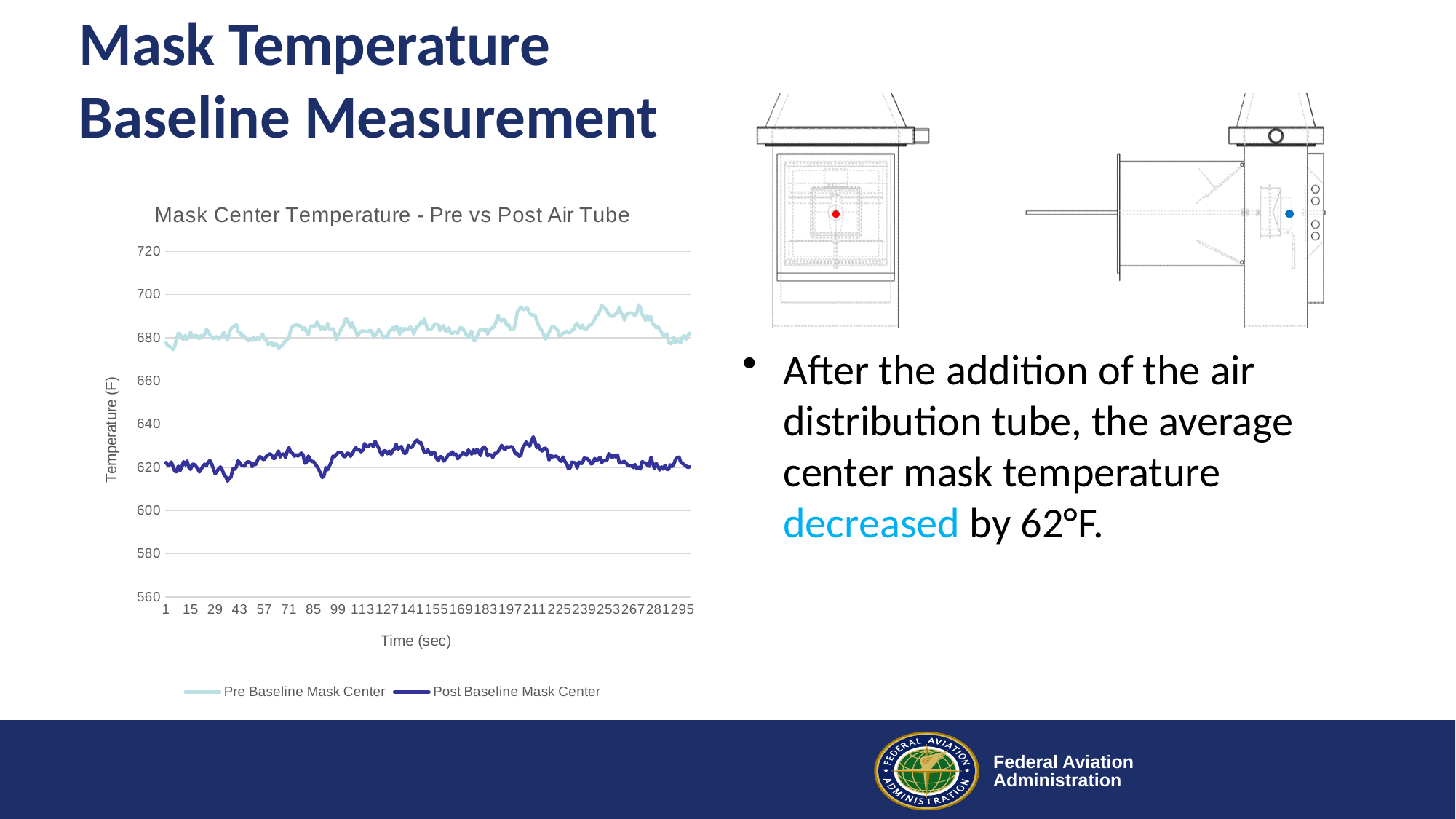
Is the Post Baseline Mask Center temperature greater or less than 600 across the chart? greater What is the title of the chart? Mask Center Temperature - Pre vs Post Air Tube What is the label of the x axis? Time (sec) What is the highest value shown on the y axis? 720 Is the Post Baseline Mask Center temperature greater or less than 660 across the chart? less How many series does the chart legend list? 2 Is the Pre Baseline Mask Center temperature greater or less than 700 at time 1 sec? less Which series has higher temperature values throughout the chart, Pre Baseline Mask Center or Post Baseline Mask Center? Pre Baseline Mask Center What kind of chart is shown on the slide? line chart